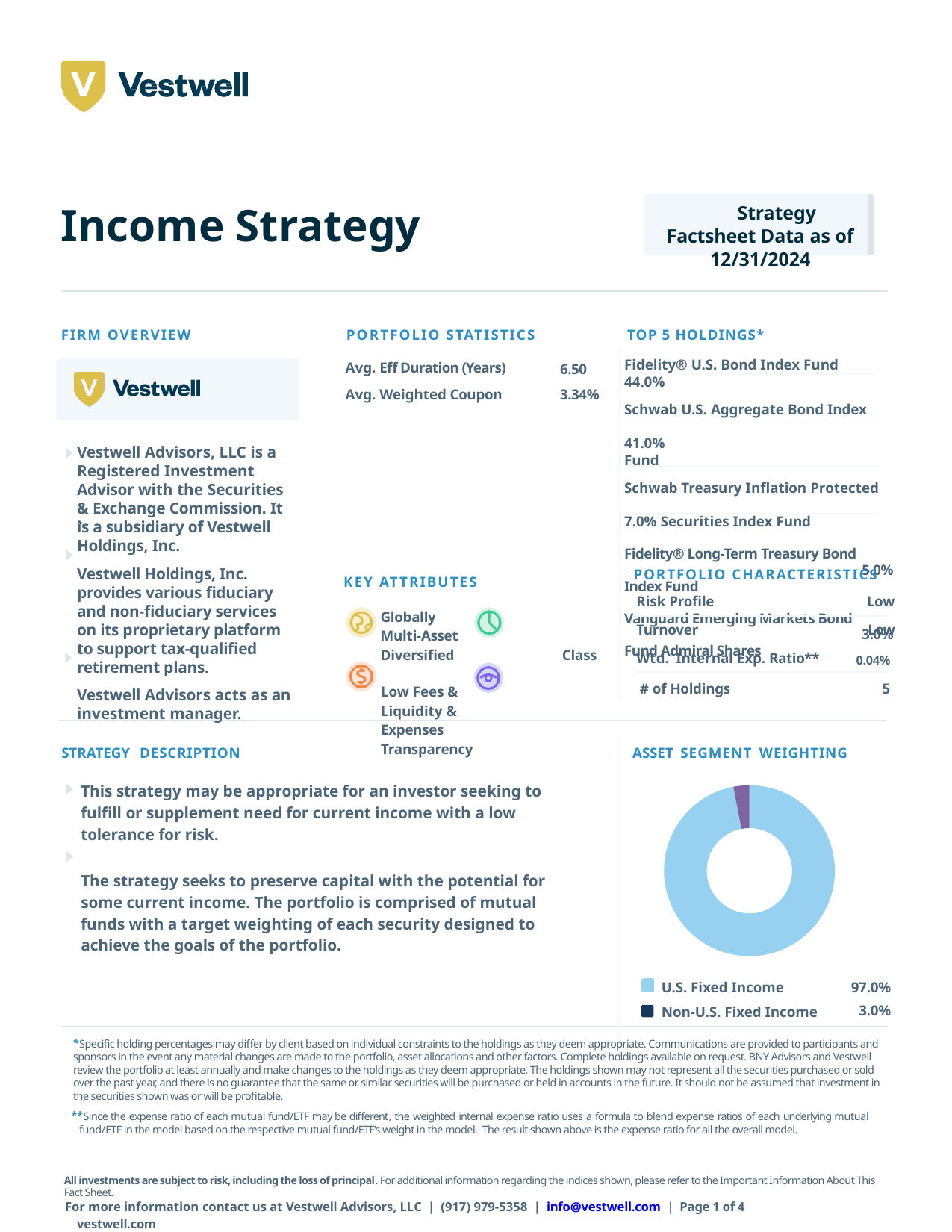
What is the difference between the U.S. Fixed Income and Non-U.S. Fixed Income values in the Asset Segment Weighting chart? 94.0% In the Asset Segment Weighting chart, which is larger: U.S. Fixed Income or Non-U.S. Fixed Income? U.S. Fixed Income How many segments does the Asset Segment Weighting chart have? 2 What is the value for U.S. Fixed Income in the Asset Segment Weighting chart? 97.0% What is the title of the chart on the slide? Asset Segment Weighting How many entries does the legend of the Asset Segment Weighting chart list? 2 What is the value for Non-U.S. Fixed Income in the Asset Segment Weighting chart? 3.0% Which segment is the largest in the Asset Segment Weighting chart? U.S. Fixed Income Which segment is the smallest in the Asset Segment Weighting chart? Non-U.S. Fixed Income What kind of chart is shown under Asset Segment Weighting? Pie chart (donut) What colour is the U.S. Fixed Income segment in the Asset Segment Weighting chart? Light blue What share of the Asset Segment Weighting pie does Non-U.S. Fixed Income represent? 3.0%